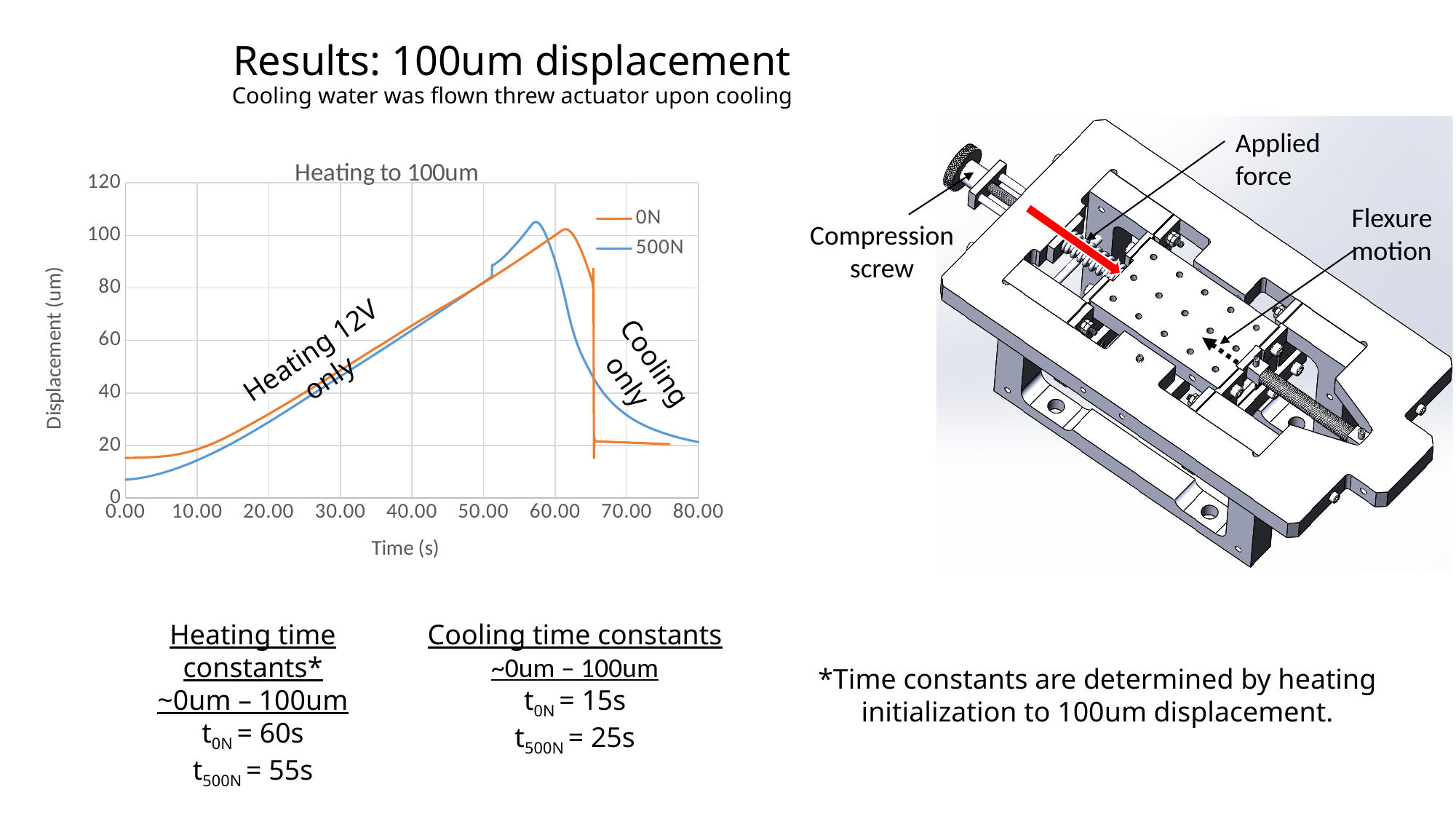
What kind of chart is shown on the slide? line chart Which series reaches its peak displacement earlier in time, 0N or 500N? 500N Is the displacement of the 500N series at time 0.00 s greater or less than 20 um? less What is the title of the chart? Heating to 100um What is the label of the y axis of the chart? Displacement (um) Is the displacement of the 0N series at 70.00 s greater or less than 40 um? less Is the peak displacement of the 500N series greater or less than 100 um? greater Between 10.00 s and 50.00 s, does the displacement of the 0N series rise or fall? rise How many series does the legend of the chart list? 2 At time 0.00 s, which series has the higher displacement, 0N or 500N? 0N After about 65 s, does the displacement of the 500N series rise or fall? fall